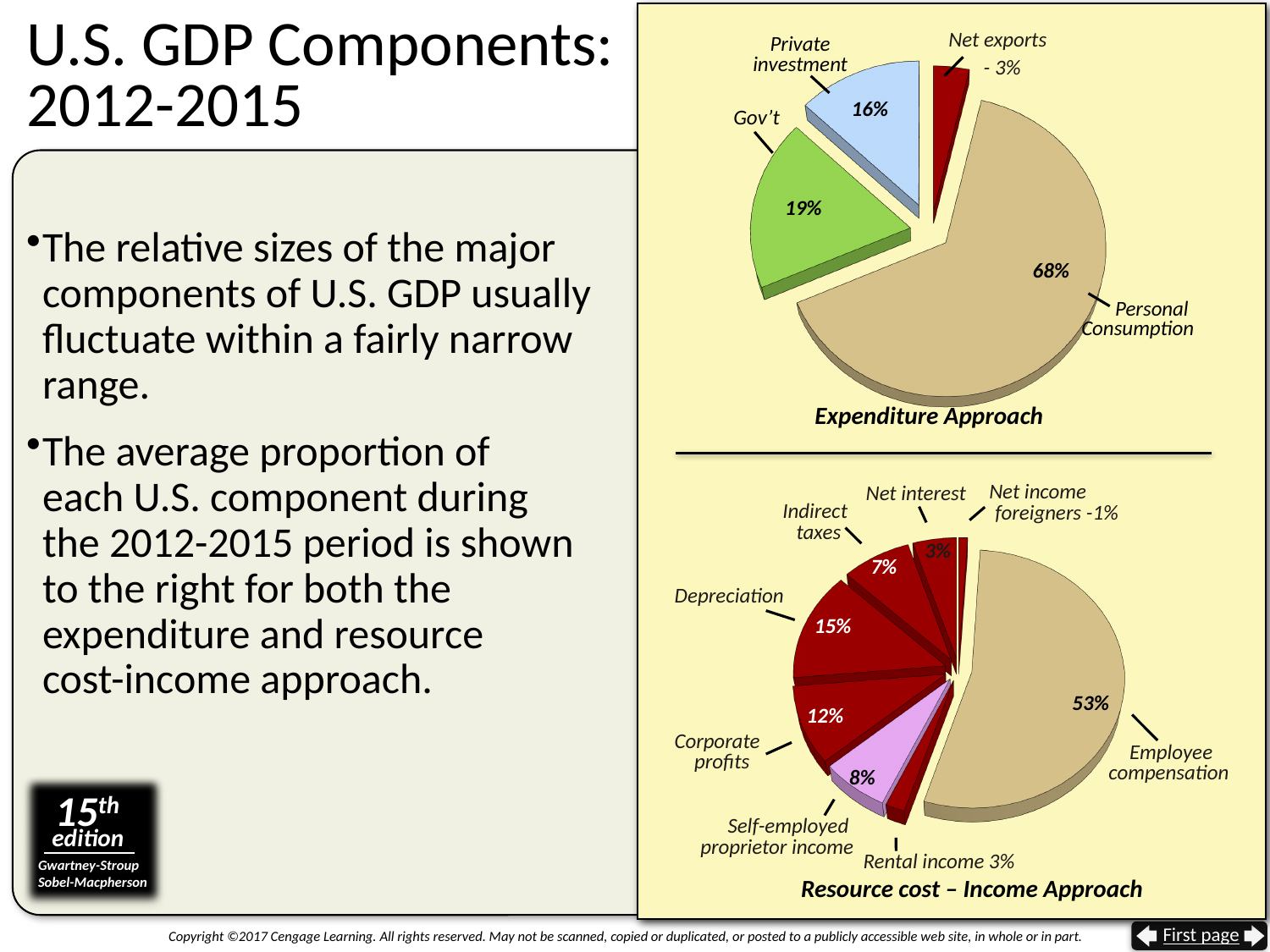
In the Resource cost – Income Approach pie chart, what is the difference between Depreciation and Indirect taxes? 8% What type of chart is used for the Expenditure Approach? Pie chart In the Resource cost – Income Approach pie chart, what share is Depreciation? 15% In the Expenditure Approach pie chart, which component has the largest share? Personal Consumption In the Expenditure Approach pie chart, what share is Gov't? 19% In the Resource cost – Income Approach pie chart, which is larger, Corporate profits or Self-employed proprietor income? Corporate profits In the Resource cost – Income Approach pie chart, how many components are shown? 8 In the Expenditure Approach pie chart, what share is Personal Consumption? 68% In the Resource cost – Income Approach pie chart, what share is Employee compensation? 53% In the Expenditure Approach pie chart, what value is shown for Net exports? -3% In the Expenditure Approach pie chart, how many components are shown? 4 In the Expenditure Approach pie chart, what is the difference between the Gov't share and the Private investment share? 3%